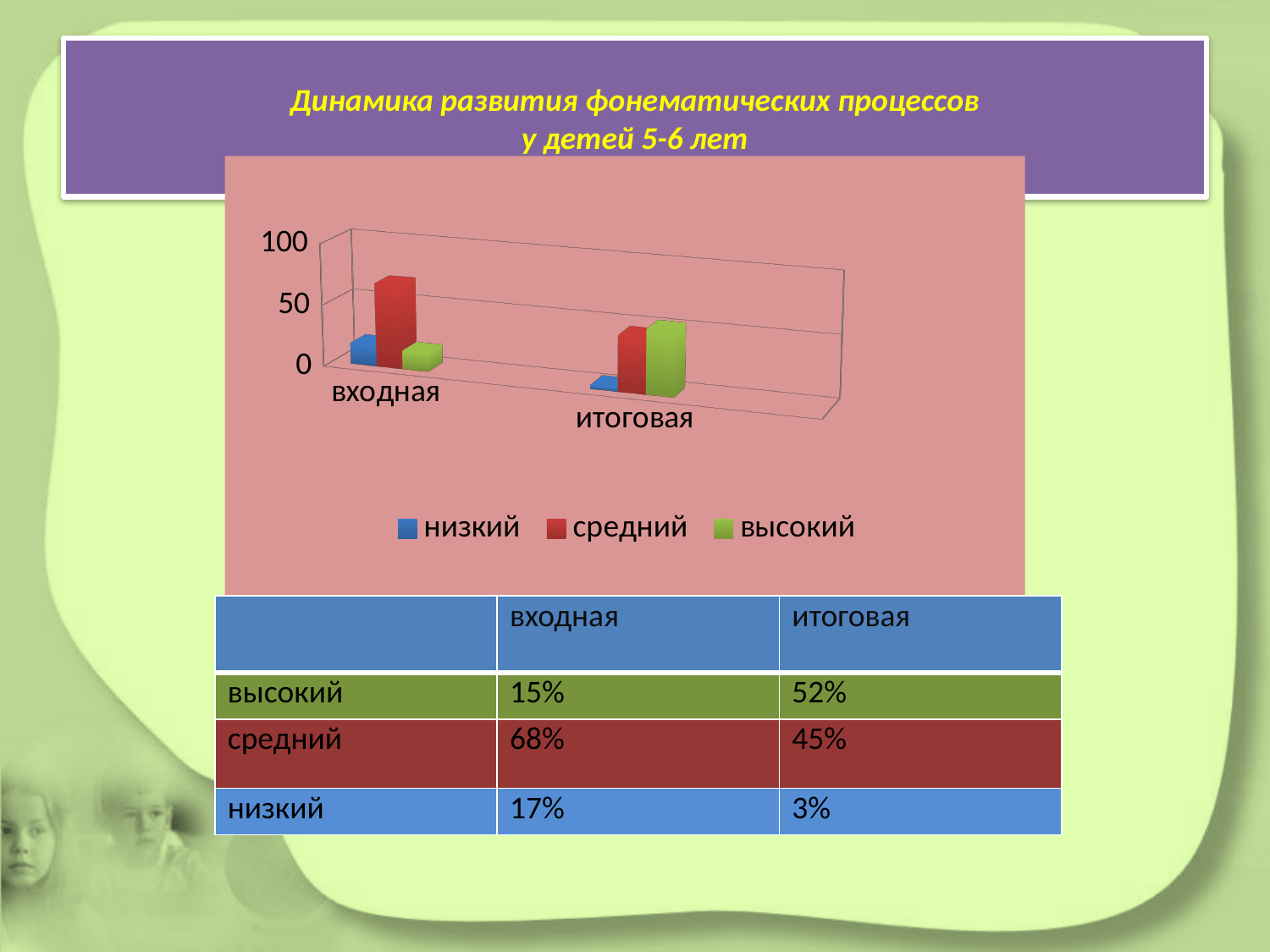
Is the value for средний in the входная category greater or less than 50? greater How many series does the chart legend list? 3 What kind of chart is shown on the slide? bar chart Which is larger: высокий in входная or высокий in итоговая? высокий in итоговая What is the difference between the высокий values for итоговая and входная? 37% Which series is shown in green in the chart legend? высокий What is the value for низкий in the итоговая category? 3% What is the value for средний in the входная category? 68% How many categories are shown on the x axis of the chart? 2 Which series has the highest value in the входная category? средний What is the value for высокий in the итоговая category? 52% Which series has the lowest value in the итоговая category? низкий